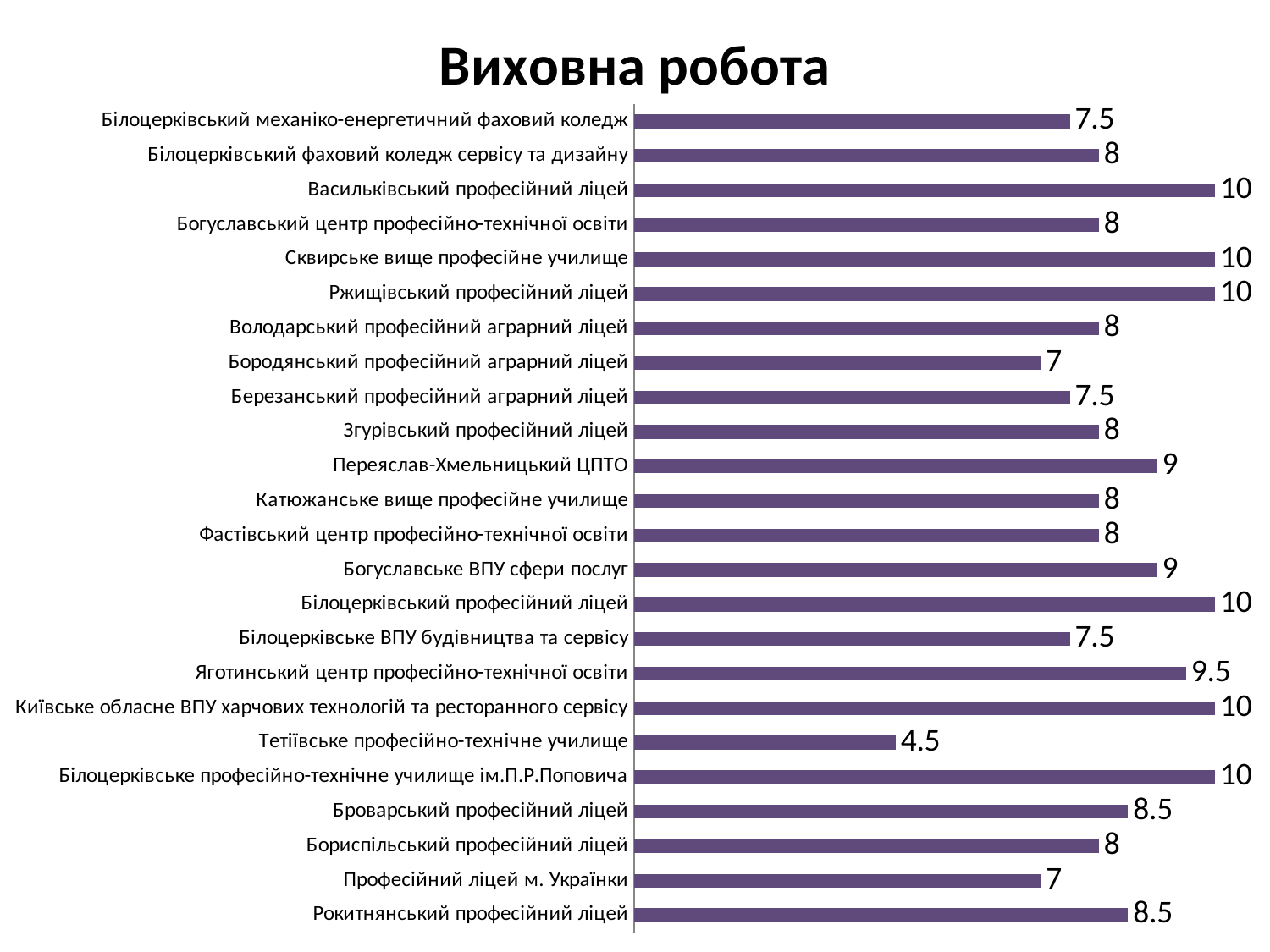
How many institutions (categories) are shown in the chart? 24 How many institutions have a value of 10? 6 What is the difference between the values for Васильківський професійний ліцей and Тетіївське професійно-технічне училище? 5.5 Which institution has the lowest value in the chart? Тетіївське професійно-технічне училище What is the value for Броварський професійний ліцей? 8.5 What is the difference between the values for Рокитнянський професійний ліцей and Професійний ліцей м. Українки? 1.5 What is the title of the chart? Виховна робота Which has a larger value: Переяслав-Хмельницький ЦПТО or Згурівський професійний ліцей? Переяслав-Хмельницький ЦПТО What kind of chart is shown on the slide? bar chart What is the value for Бородянський професійний аграрний ліцей? 7 What is the value for Яготинський центр професійно-технічної освіти? 9.5 What is the value for Тетіївське професійно-технічне училище? 4.5